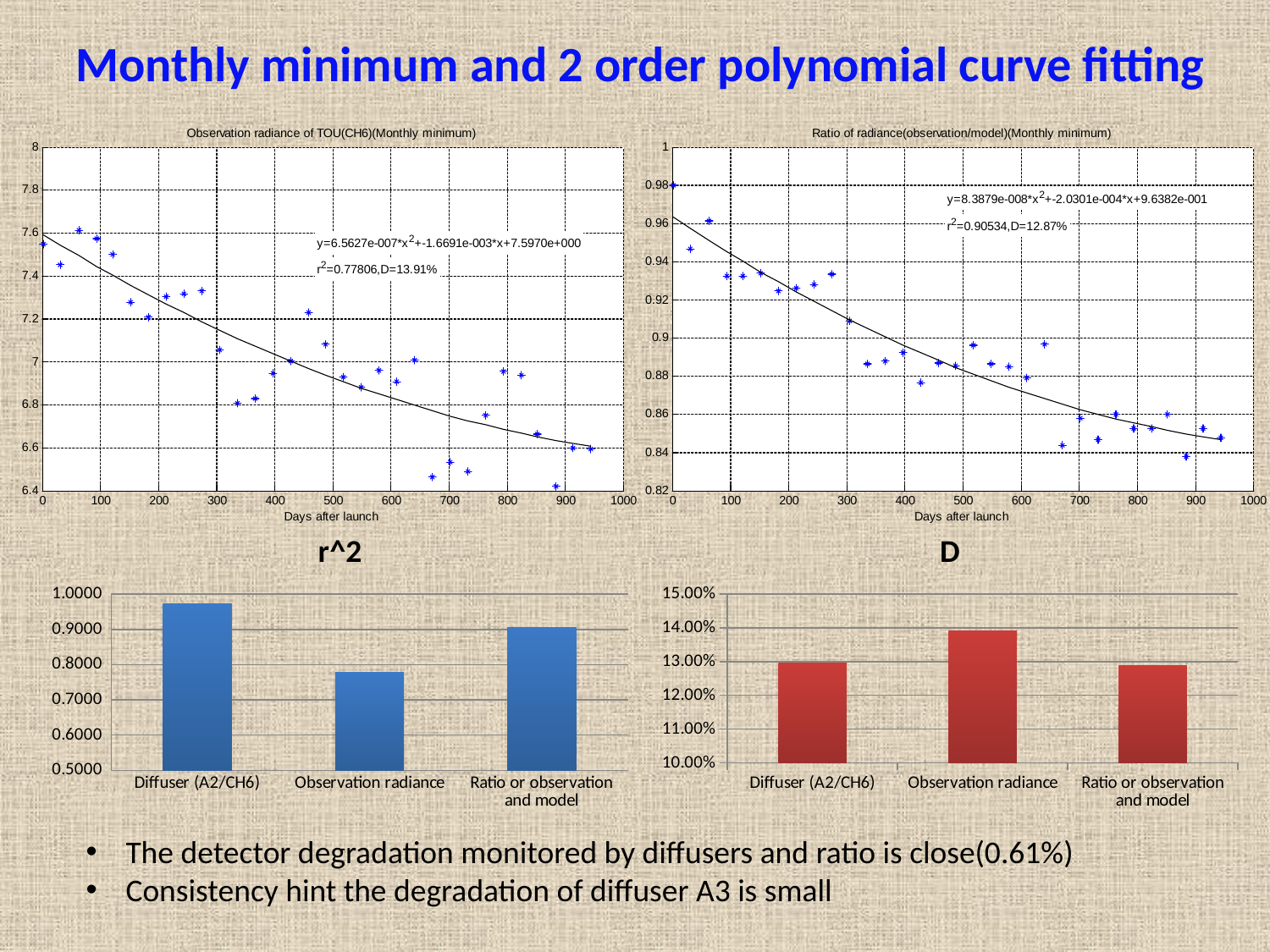
What kind of chart is the bottom-left chart titled "r^2"? bar chart In the bottom-left "r^2" chart, which category has the highest value? Diffuser (A2/CH6) In the top-left chart "Observation radiance of TOU(CH6)(Monthly minimum)", what r^2 value is printed for the fitted curve? 0.77806 In the bottom-left "r^2" chart, which category has the lowest value? Observation radiance In the bottom-right "D" chart, is the value for Observation radiance greater or less than 13.00%? greater In the bottom-left "r^2" chart, is the value for Observation radiance greater or less than 0.8000? less In the bottom-right "D" chart, which category has the highest value? Observation radiance In the bottom-right "D" chart, is the value for Diffuser (A2/CH6) greater or less than 12.00%? greater How many categories are shown in the bottom-left "r^2" bar chart? 3 In the top-left chart "Observation radiance of TOU(CH6)(Monthly minimum)", do the plotted values generally rise or fall as days after launch increase? fall In the top-right chart "Ratio of radiance(observation/model)(Monthly minimum)", what D value is printed for the fitted curve? 12.87% In the bottom-left "r^2" chart, which is larger: Diffuser (A2/CH6) or Ratio or observation and model? Diffuser (A2/CH6)